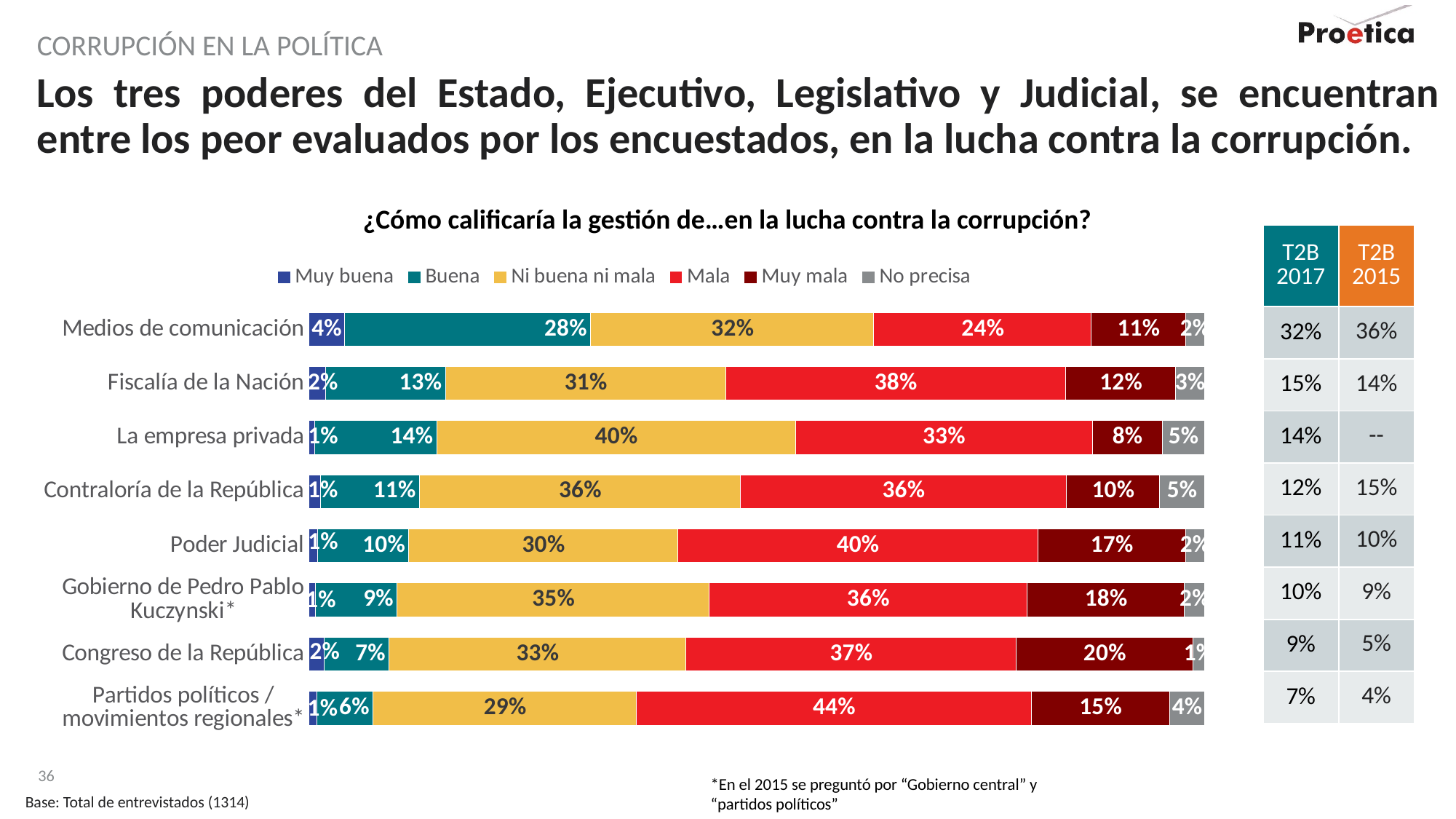
What kind of chart is shown on the slide? Stacked bar chart What is the "Muy mala" value for Congreso de la República? 20% Which category has the highest "Mala" value? Partidos políticos / movimientos regionales How many series does the legend list? 6 What percentage of respondents rated the Medios de comunicación as "Buena" in the fight against corruption? 28% How many categories (institutions) are shown in the chart? 8 What is the total of the stacked bar for Poder Judicial? 100% Which category has the lowest "Buena" value? Partidos políticos / movimientos regionales What is the title of the chart? ¿Cómo calificaría la gestión de…en la lucha contra la corrupción? What is the "Mala" value for Poder Judicial? 40% What is the difference between the "Ni buena ni mala" values for La empresa privada and Partidos políticos / movimientos regionales? 11% Which has a larger "Muy mala" value, Poder Judicial or Gobierno de Pedro Pablo Kuczynski? Gobierno de Pedro Pablo Kuczynski